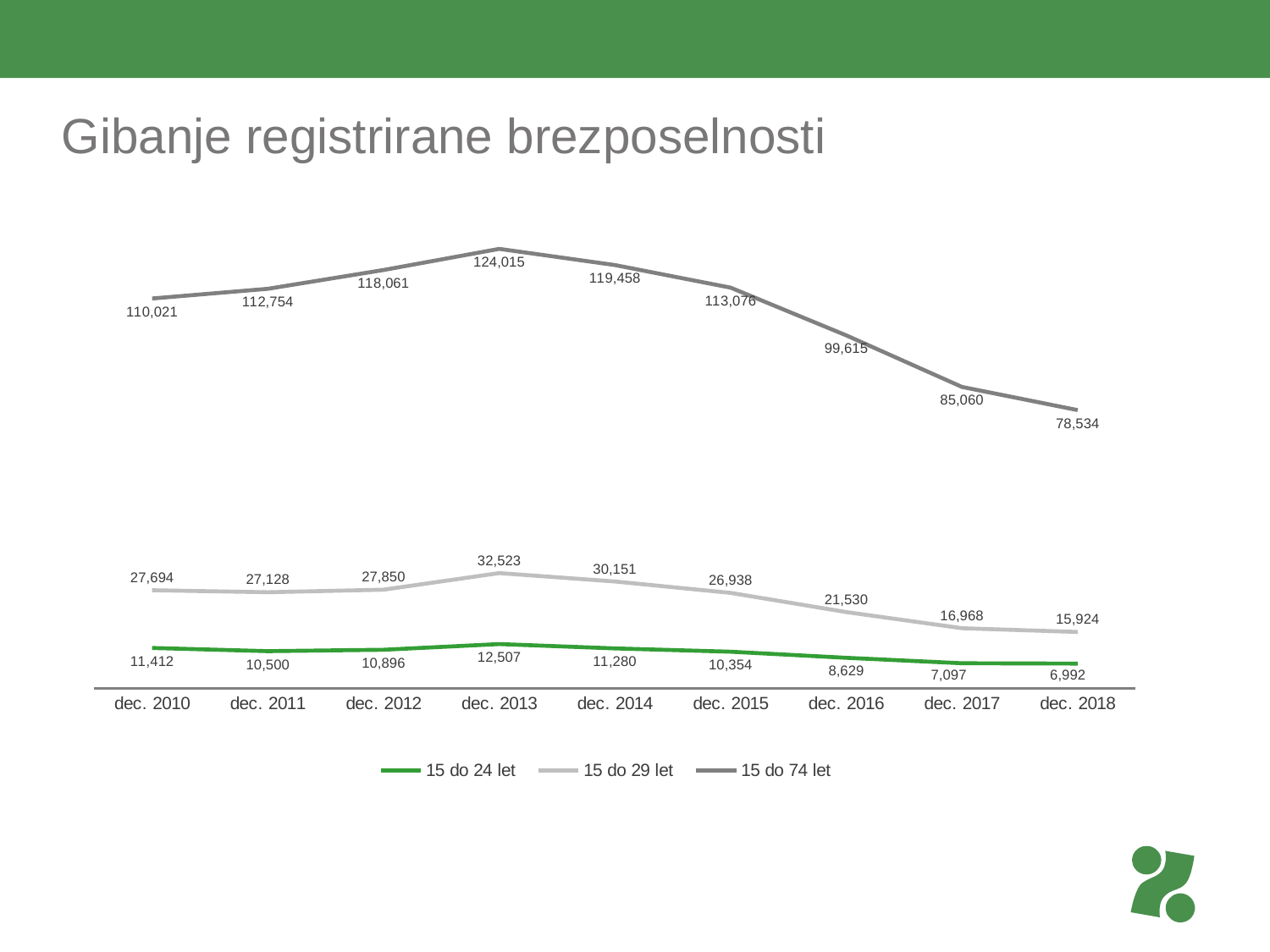
Does the 15 do 74 let series rise or fall from dec. 2013 to dec. 2018? fall What is the difference between the 15 do 29 let and 15 do 24 let values in dec. 2013? 20,016 What is the value for the 15 do 24 let series in dec. 2018? 6,992 What is the value for the 15 do 29 let series in dec. 2016? 21,530 How many time points are shown on the x axis? 9 In which period does the 15 do 29 let series reach its lowest value? dec. 2018 What is the value for the 15 do 74 let series in dec. 2013? 124,015 What is the difference between the 15 do 74 let values in dec. 2010 and dec. 2018? 31,487 How many series does the legend list? 3 What kind of chart is shown on the slide? line chart Which is larger for the 15 do 24 let series: dec. 2010 or dec. 2011? dec. 2010 In which period does the 15 do 74 let series reach its highest value? dec. 2013